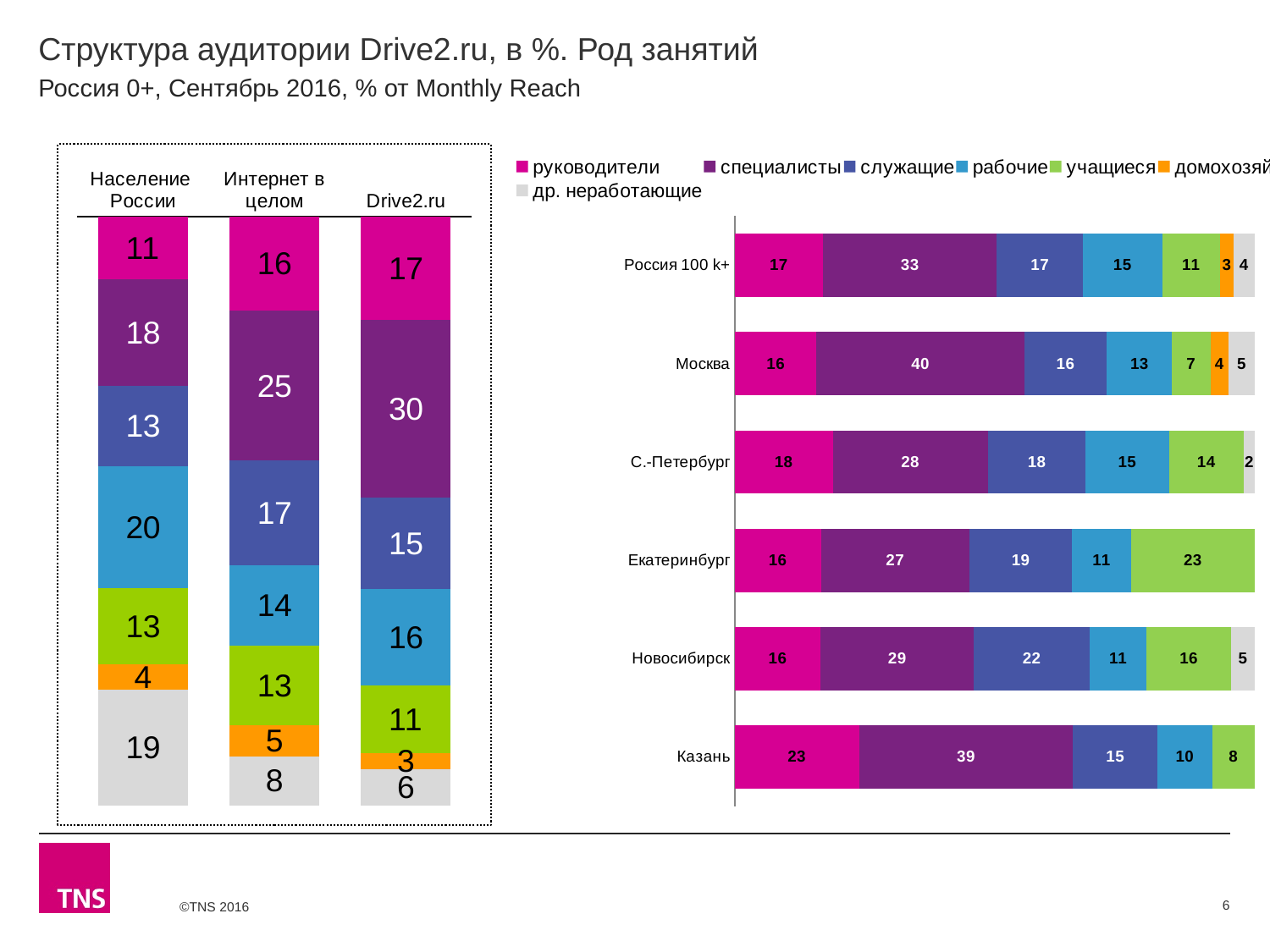
In the right chart, which city has the highest value for учащиеся? Екатеринбург In the left chart, what is the value for рабочие in the Население России bar? 20 In the right chart, what is the value for учащиеся for Екатеринбург? 23 How many series does the legend list? 7 What is the title of the slide? Структура аудитории Drive2.ru, в %. Род занятий In the right chart, which city has the highest value for руководители? Казань In the right chart, what is the value for специалисты for Москва? 40 In the left chart, what is the difference between the специалисты value for Drive2.ru and for Население России? 12 In the right chart, which is larger: the служащие value for Новосибирск or for Казань? Новосибирск How many cities/regions are shown in the right chart? 6 What type of chart is the right chart? Stacked bar chart In the left chart, what is the value for специалисты in the Drive2.ru bar? 30